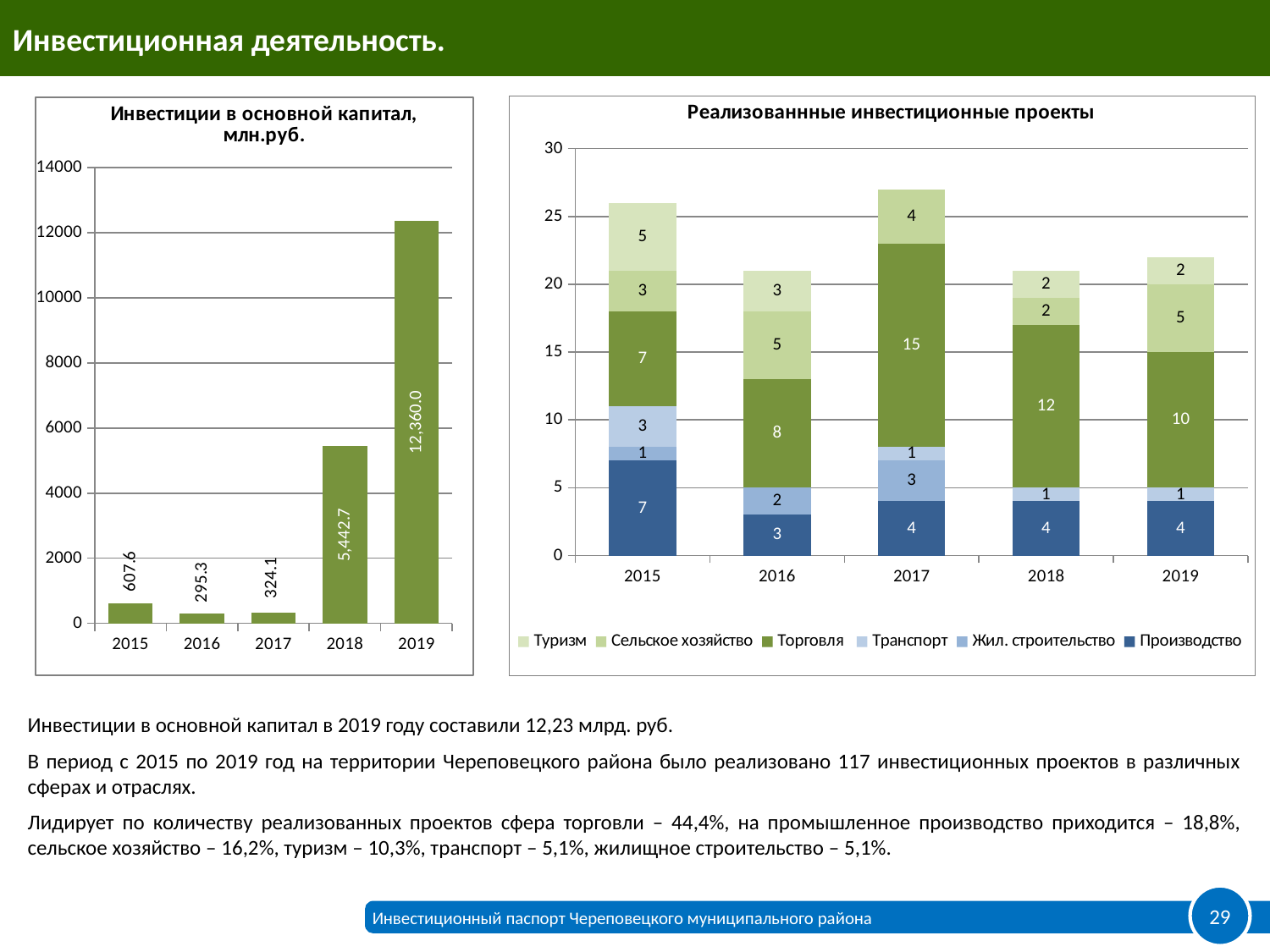
In the chart 'Реализованнные инвестиционные проекты', how many series does the legend list? 6 In the chart 'Реализованнные инвестиционные проекты', what is the value for Производство in 2015? 7 In the chart 'Инвестиции в основной капитал, млн.руб.', what is the value for 2016? 295.3 In the chart 'Инвестиции в основной капитал, млн.руб.', what is the value for 2019? 12,360.0 In the chart 'Инвестиции в основной капитал, млн.руб.', which year has the lowest value? 2016 In the chart 'Инвестиции в основной капитал, млн.руб.', what is the difference between the 2019 and 2018 values? 6,917.3 In the chart 'Реализованнные инвестиционные проекты', what is the total of the stacked bar for 2015? 26 What kind of chart is 'Реализованнные инвестиционные проекты'? Stacked bar chart In the chart 'Реализованнные инвестиционные проекты', what is the value for Торговля in 2017? 15 In the chart 'Инвестиции в основной капитал, млн.руб.', how many years are shown on the x axis? 5 In the chart 'Реализованнные инвестиционные проекты', which is larger: Торговля in 2018 or Торговля in 2019? Торговля in 2018 In the chart 'Реализованнные инвестиционные проекты', what is the total of the stacked bar for 2017? 27